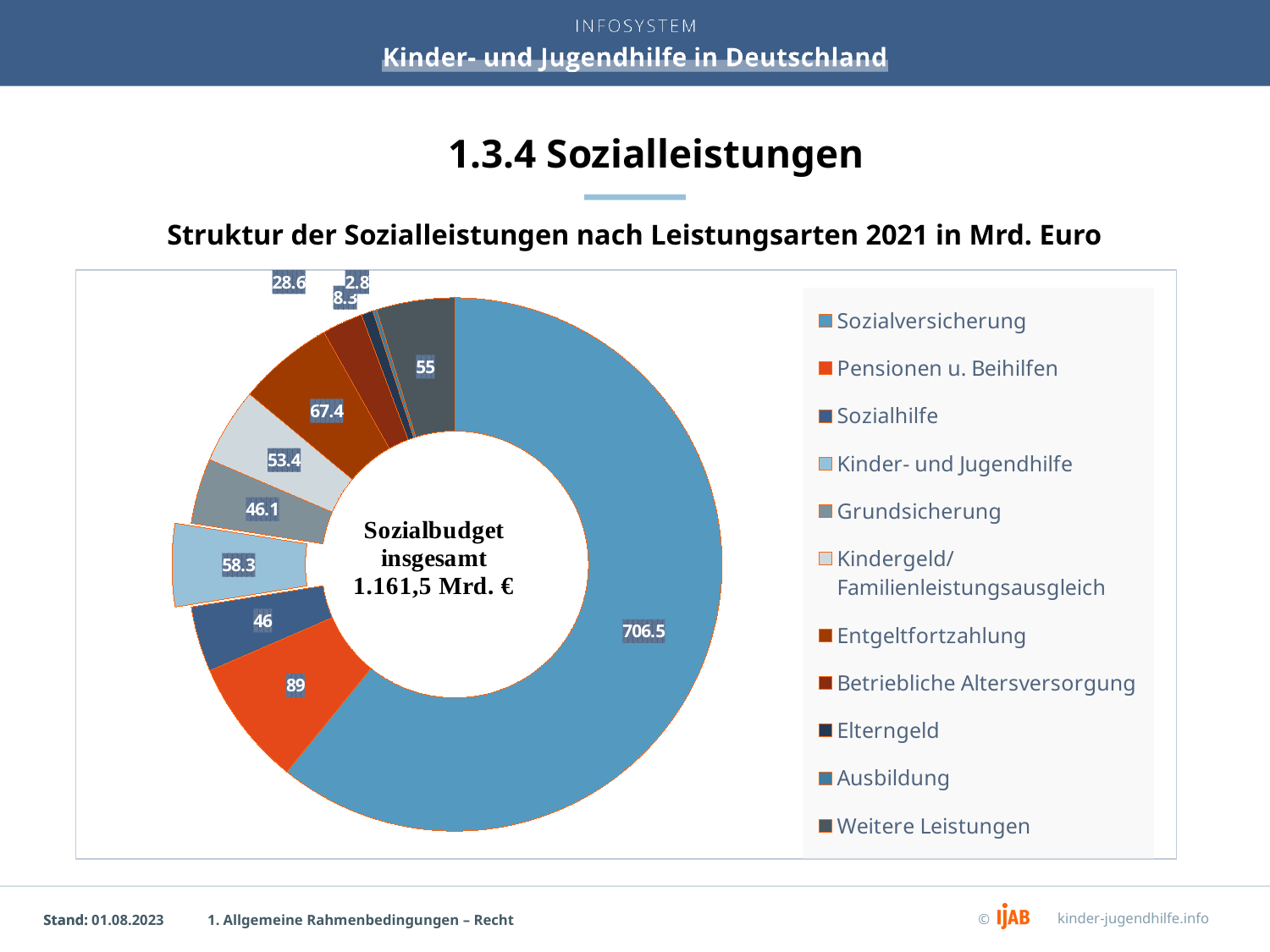
What total Sozialbudget is stated in the centre of the chart? 1.161,5 Mrd. € What is the value for Elterngeld? 8.3 What is the difference between Entgeltfortzahlung and Kindergeld/Familienleistungsausgleich? 14 What is the difference between Pensionen u. Beihilfen and Sozialhilfe? 43 Which category has the lowest value? Ausbildung What is the value for Kinder- und Jugendhilfe? 58.3 What is the value for Entgeltfortzahlung? 67.4 Which category has the highest value? Sozialversicherung Which is larger, Kinder- und Jugendhilfe or Weitere Leistungen? Kinder- und Jugendhilfe What type of chart is shown on the slide? Doughnut (pie) chart What is the value for Sozialversicherung? 706.5 How many categories does the legend list? 11